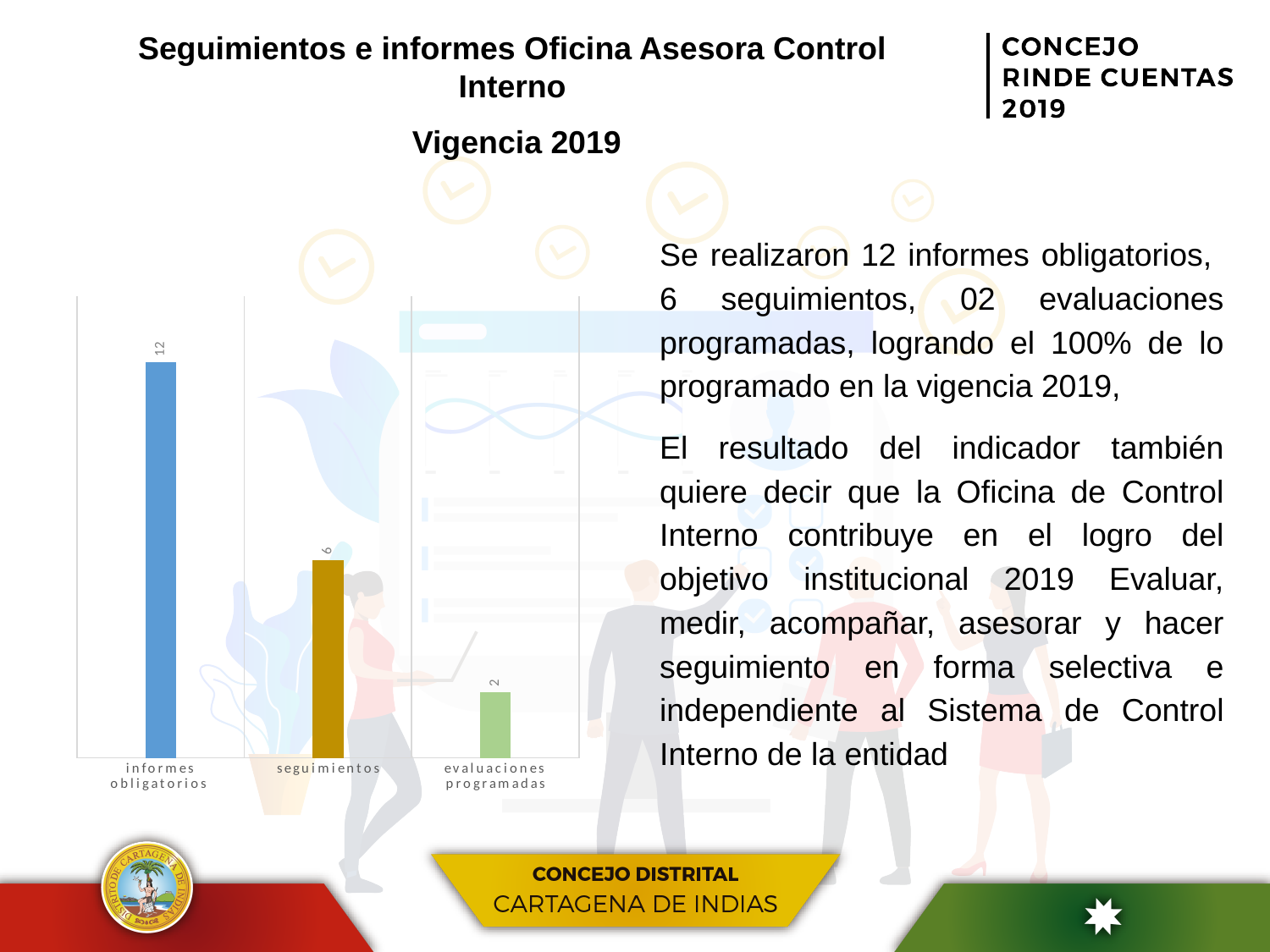
How many categories are shown in the chart? 3 Which category has the lowest value? evaluaciones programadas What kind of chart is shown on the slide? bar chart What is the difference between informes obligatorios and seguimientos? 6 What is the value for informes obligatorios? 12 What is the difference between seguimientos and evaluaciones programadas? 4 Do the values rise or fall from left to right across the categories? fall What is the value for seguimientos? 6 Which category has the highest value? informes obligatorios What colour is the bar for seguimientos? gold What is the value for evaluaciones programadas? 2 Which is larger, seguimientos or evaluaciones programadas? seguimientos